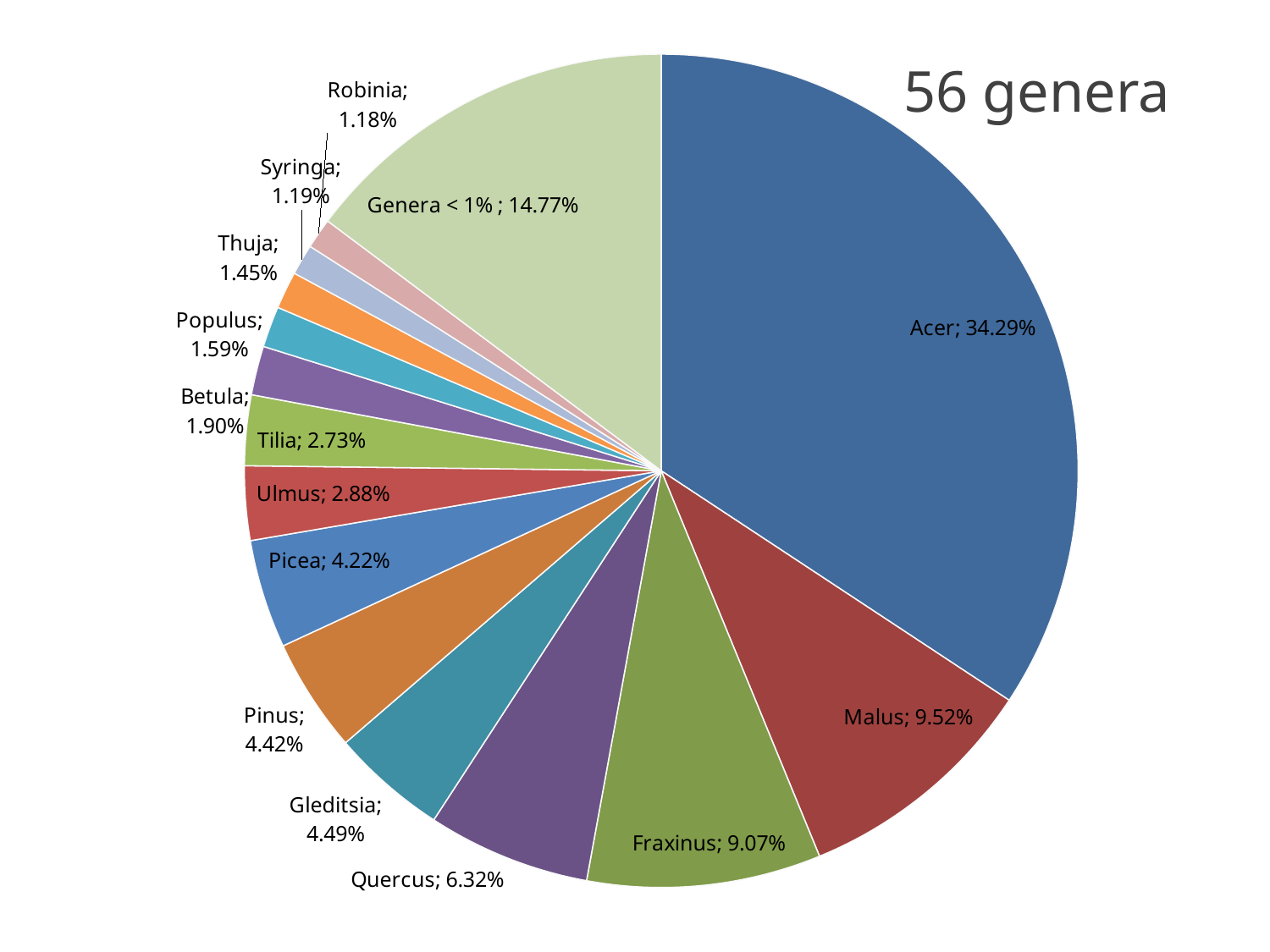
What type of chart is shown on the slide? pie chart What is the value shown for Quercus? 6.32% What percentage is shown for the 'Genera < 1%' slice? 14.77% What is the value shown for Malus? 9.52% Which genus has the largest slice of the pie? Acer What is the difference in percentage points between Acer and Malus? 24.77% Which is larger, the slice for Fraxinus or the slice for Quercus? Fraxinus What percentage is shown for Betula? 1.90% What text is shown in the top-right corner of the chart? 56 genera How many slices does the pie chart have? 15 Which is larger, the slice for Picea or the slice for Ulmus? Picea What percentage share does Acer have? 34.29%